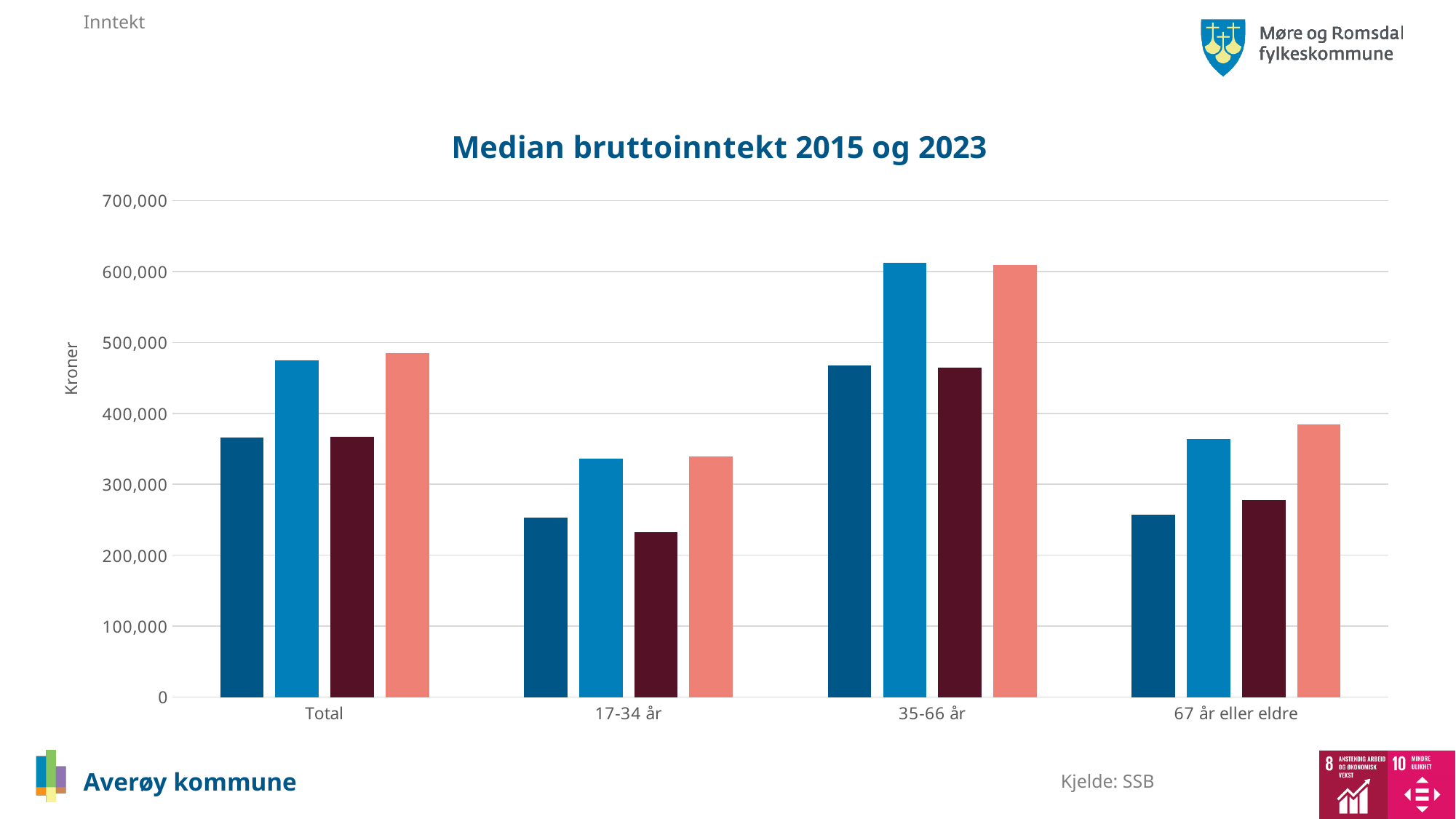
Which category contains the tallest bar in the chart? 35-66 år Which category contains the shortest bar in the chart? 17-34 år What is the title of the chart? Median bruttoinntekt 2015 og 2023 Is the value of the dark blue bar for 17-34 år greater or less than 300,000? less For 67 år eller eldre, which is larger: the salmon bar or the dark blue bar? the salmon bar How many categories are shown on the x axis of the chart? 4 What is the label on the y axis of the chart? Kroner Is the value of the salmon bar for Total greater or less than 400,000? greater Is the value of the light blue bar for 35-66 år greater or less than 600,000? greater What kind of chart is shown on the slide? bar chart How many bars are plotted for each category? 4